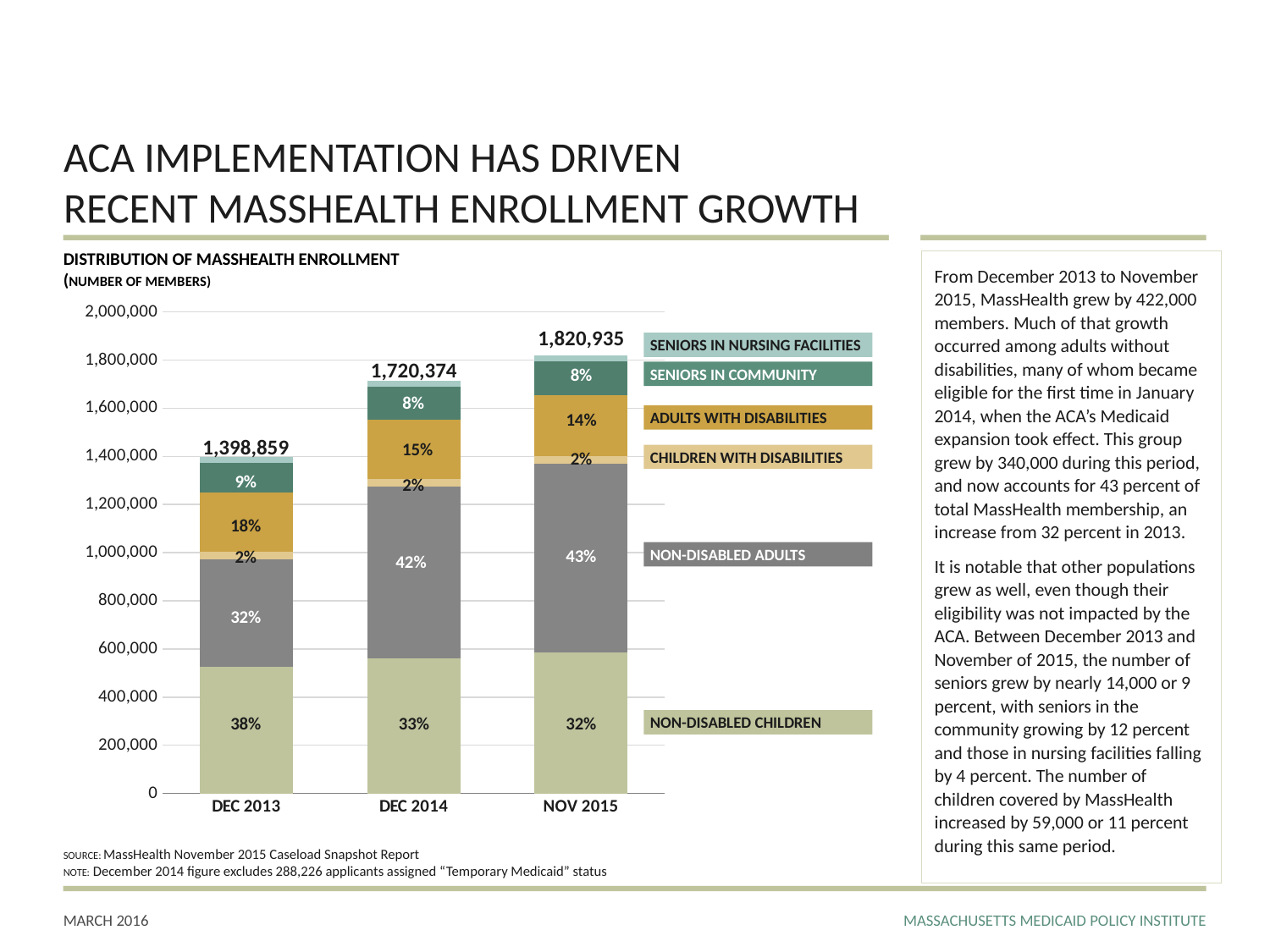
What percentage of enrollment in DEC 2013 is Adults with Disabilities? 18% Is the total enrollment for DEC 2014 greater or less than 1,600,000? greater Which period has the highest total enrollment? NOV 2015 What is the total MassHealth enrollment shown for NOV 2015? 1,820,935 What is the total enrollment shown for DEC 2013? 1,398,859 What percentage of enrollment in DEC 2014 is Non-Disabled Adults? 42% Which is larger: the Non-Disabled Children share in DEC 2013 or in NOV 2015? DEC 2013 Which period has the lowest total enrollment? DEC 2013 How many time periods are shown on the x axis? 3 What is the difference in total enrollment between NOV 2015 and DEC 2013? 422,076 Does total enrollment rise or fall from DEC 2013 to NOV 2015? rise How many enrollment categories does the legend list? 6